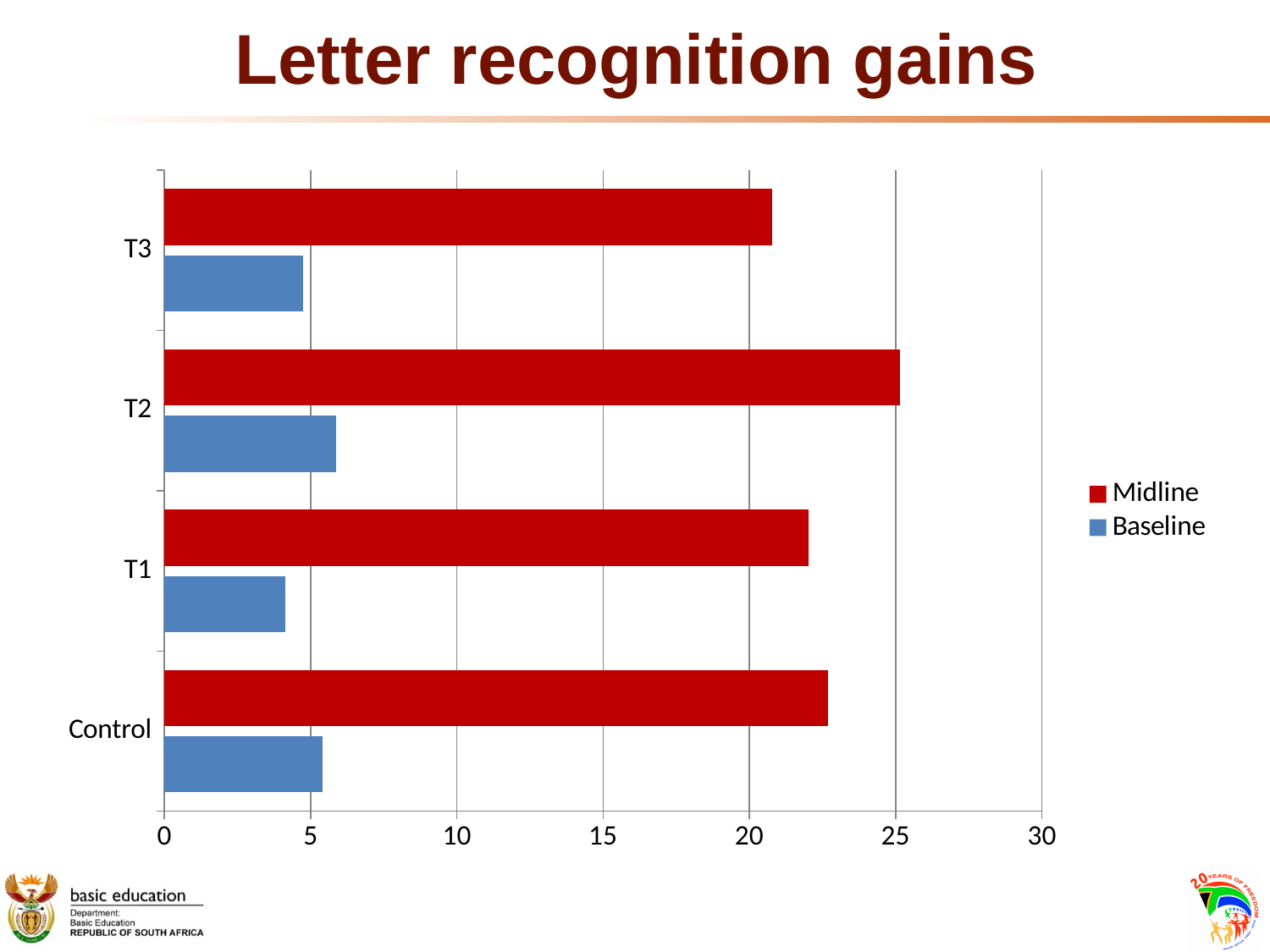
How many series does the legend list? 2 How many categories are shown on the vertical axis? 4 Is the Midline value for Control greater or less than 25? less Which category has the lowest Midline value? T3 What kind of chart is shown on the slide? Bar chart Which category has the lowest Baseline value? T1 Which colour represents the Baseline series? Blue Which is larger, the Midline value for T2 or the Midline value for Control? T2 Is the Midline value for T3 greater or less than 20? greater Is the Baseline value for T1 greater or less than 5? less What is the title of the chart? Letter recognition gains Which category has the highest Midline value? T2